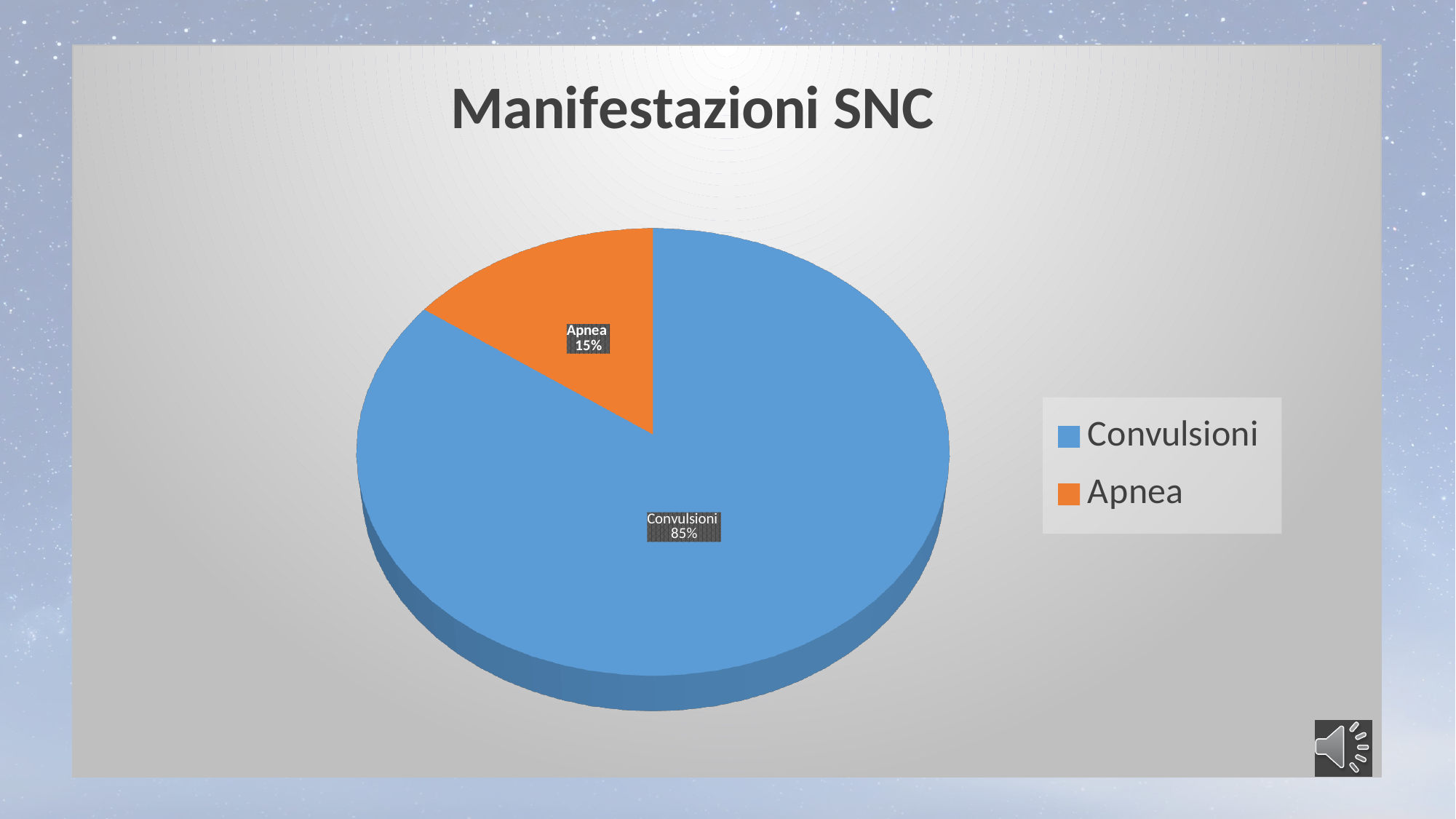
Which category has the largest slice of the pie? Convulsioni How many categories are shown in the pie chart? 2 What share of the pie does Apnea represent? 15% How many entries does the legend list? 2 What kind of chart is shown on the slide? pie chart What colour is the Apnea slice? orange What is the difference in percentage points between Convulsioni and Apnea? 70 What is the title of the chart? Manifestazioni SNC Which is larger, the share for Convulsioni or the share for Apnea? Convulsioni What share of the pie does Convulsioni represent? 85% Which category has the smallest slice of the pie? Apnea